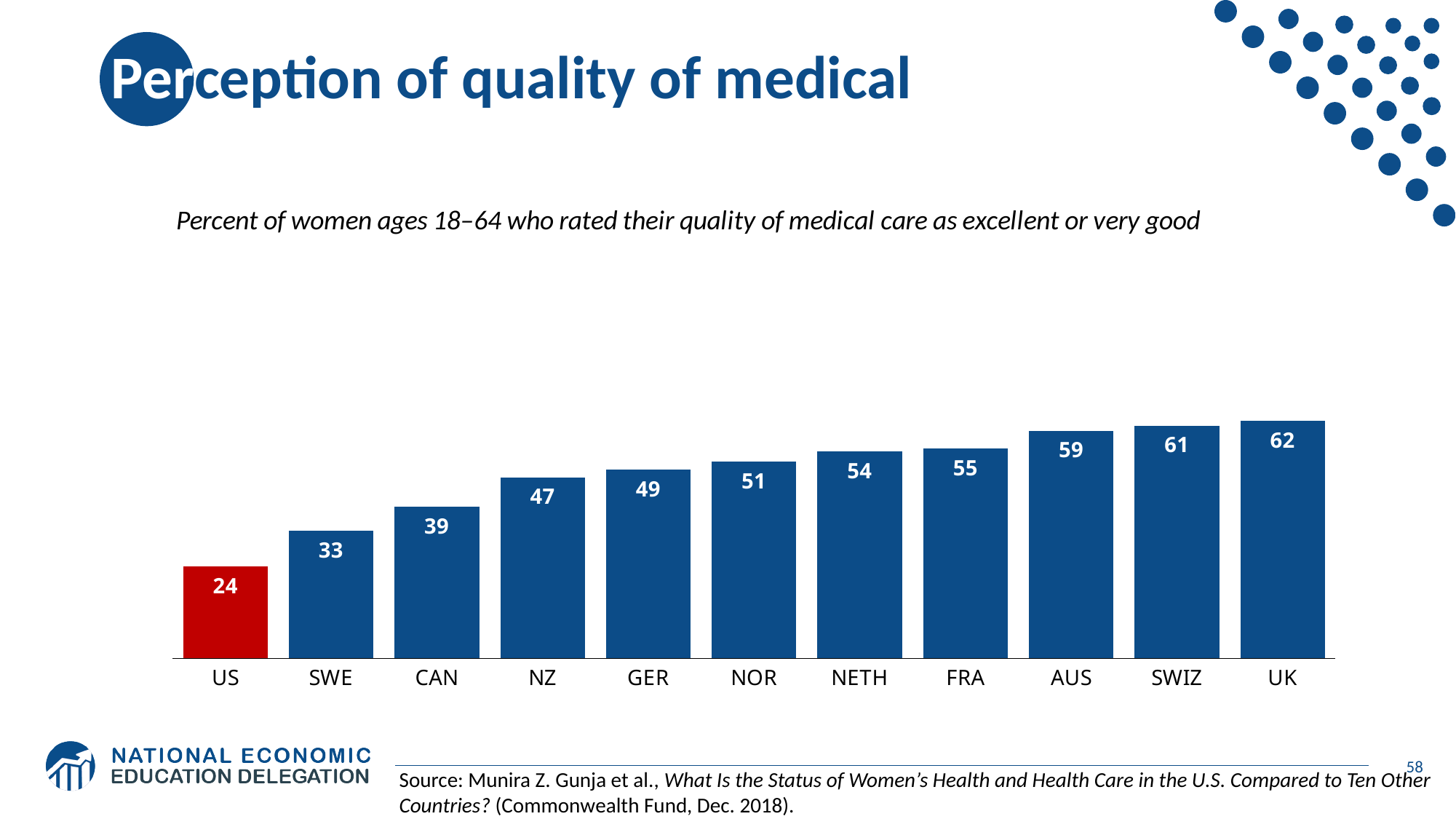
Do the values rise or fall from left to right along the x axis? rise What kind of chart is shown on the slide? bar chart What is the value for AUS? 59 What is the difference between the values for UK and US? 38 Which country has the highest value? UK What is the value for the US? 24 How many countries are shown in the chart? 11 What is the value for GER? 49 Which country has the lowest value? US Which has a larger value, NOR or NETH? NETH What is the difference between the values for CAN and SWE? 6 Which bar is coloured differently from the others? US